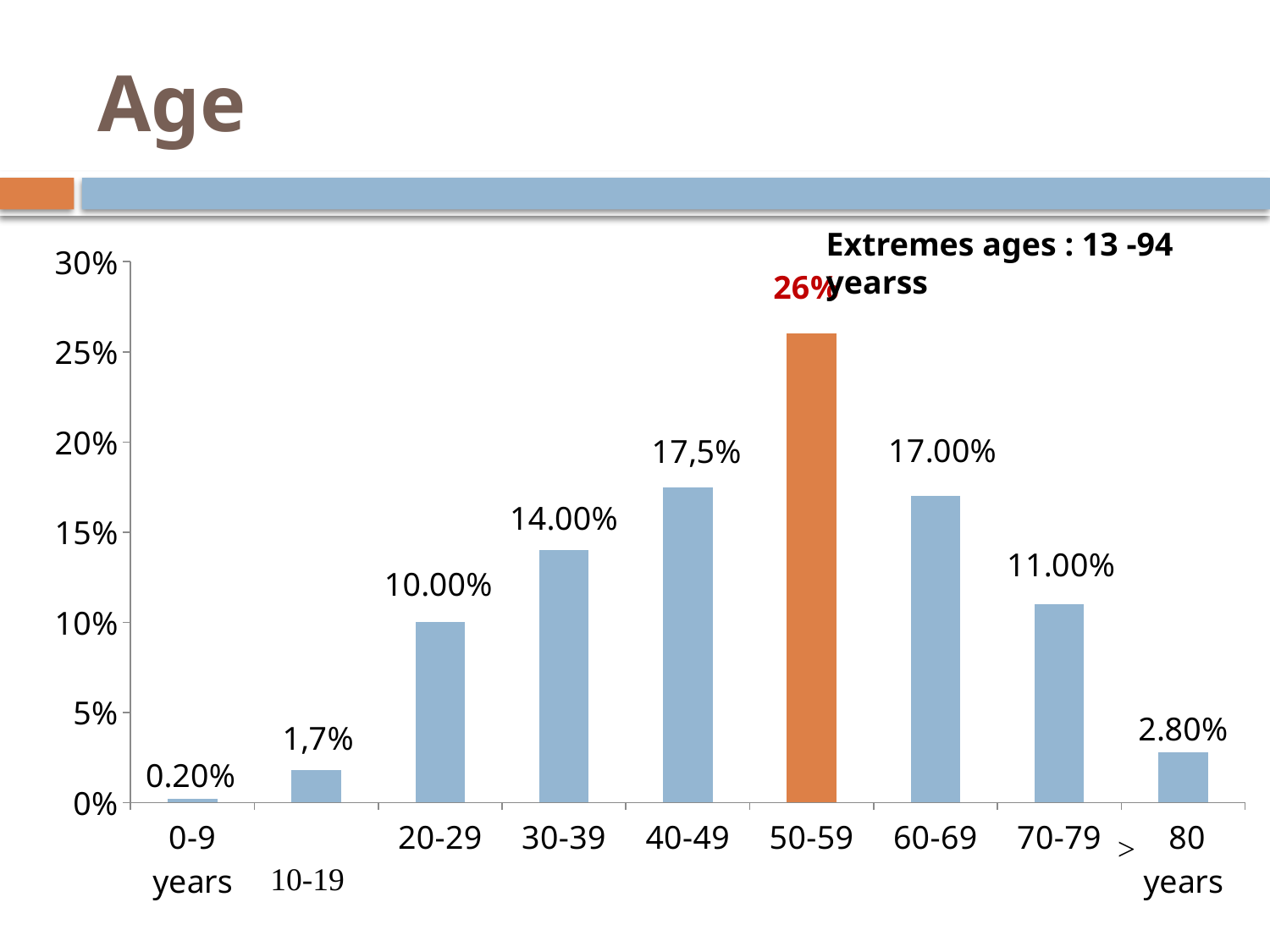
What is the value for the 50-59 age group? 26% How many age groups are shown on the chart? 9 What kind of chart is shown on the slide? Bar chart Which is larger, the value for 30-39 or the value for 70-79? 30-39 Which bar is coloured orange rather than blue? 50-59 Which age group has the lowest value? 0-9 years Which age group has the highest value? 50-59 What is the value for the > 80 years age group? 2.80% What is the difference between the values for the 50-59 and 60-69 age groups? 9% What is the value for the 0-9 years age group? 0.20% How do the values change from 0-9 years to 50-59 along the x axis? They rise What is the value for the 40-49 age group? 17,5%